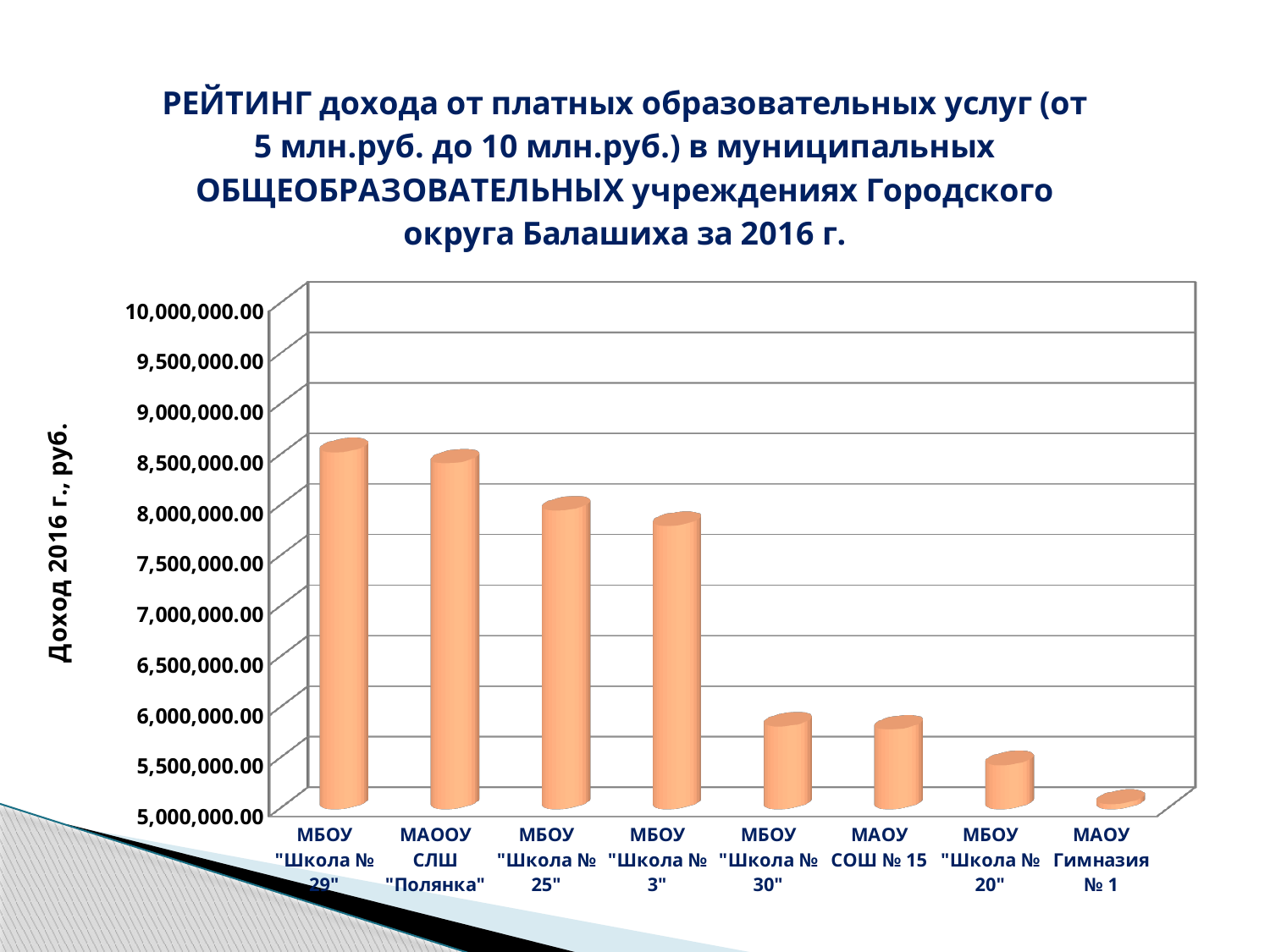
Which institution has the lowest income on the chart? МАОУ Гимназия № 1 Is the value for МАОУ Гимназия № 1 greater or less than 5,500,000.00? less Which institution has the highest income on the chart? МБОУ "Школа № 29" What kind of chart is shown on the slide? bar chart Which has the larger value: МБОУ "Школа № 25" or МАОУ СОШ № 15? МБОУ "Школа № 25" How many institutions (categories) are plotted on the chart? 8 Is the value for МБОУ "Школа № 3" greater or less than 7,500,000.00? greater What is the title of the vertical axis? Доход 2016 г., руб. Do the values rise or fall moving from left to right along the x axis? fall Is the value for МАООУ СЛШ "Полянка" greater or less than 8,000,000.00? greater